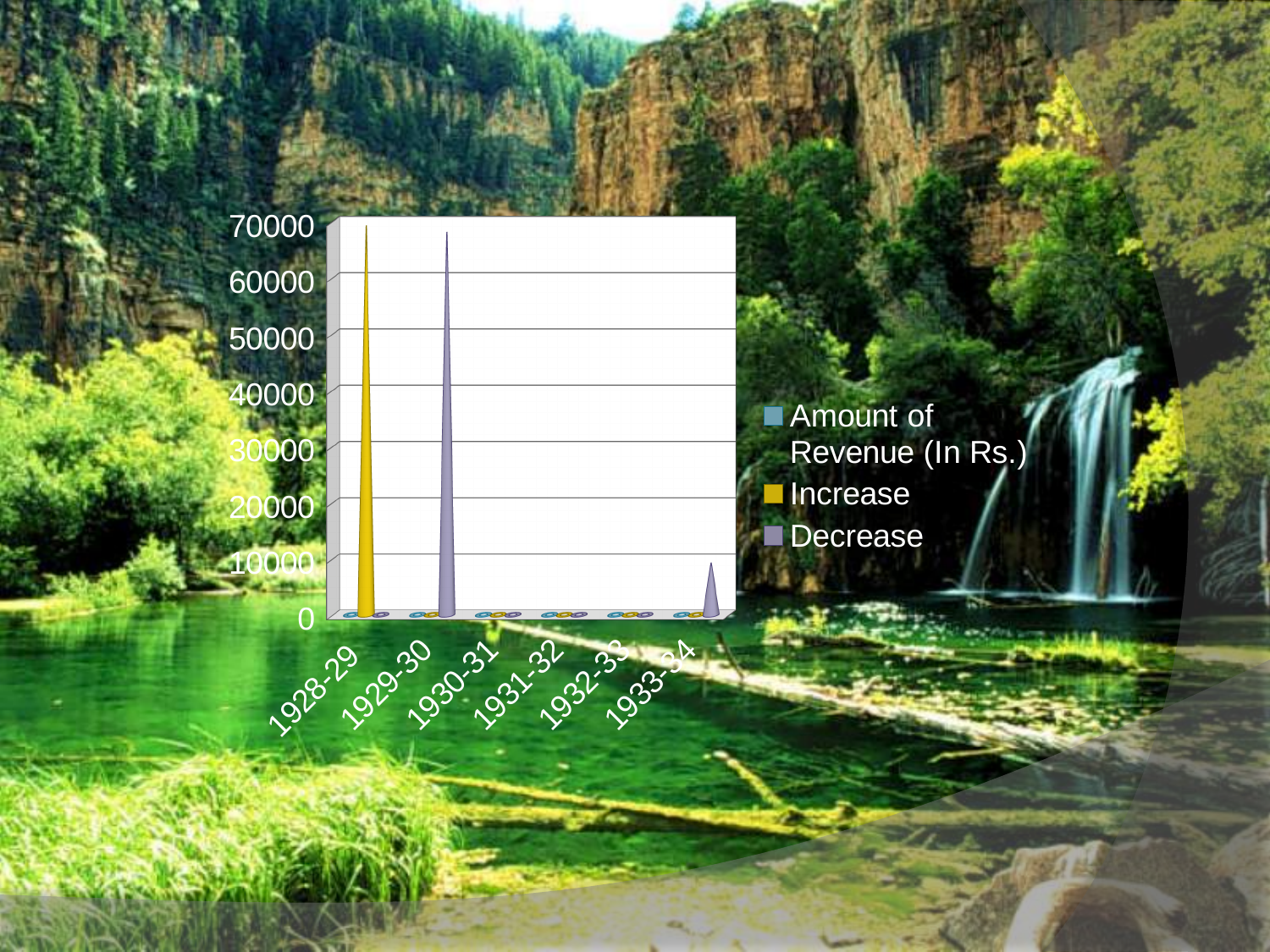
How many year categories are shown on the x axis? 6 Is the Decrease value for 1933-34 greater or less than 20000? less Is the Increase value for 1928-29 greater or less than 60000? greater Is the Decrease value for 1929-30 greater or less than 60000? greater What is the highest value shown on the vertical axis? 70000 What colour represents the Increase series in the legend? yellow Which is larger, the Increase value for 1928-29 or the Decrease value for 1933-34? Increase for 1928-29 Which is larger, the Decrease value for 1929-30 or the Decrease value for 1933-34? 1929-30 Which year has the highest Increase value? 1928-29 What kind of chart is shown on the slide? bar chart Which year has the highest Decrease value? 1929-30 How many series does the legend list? 3